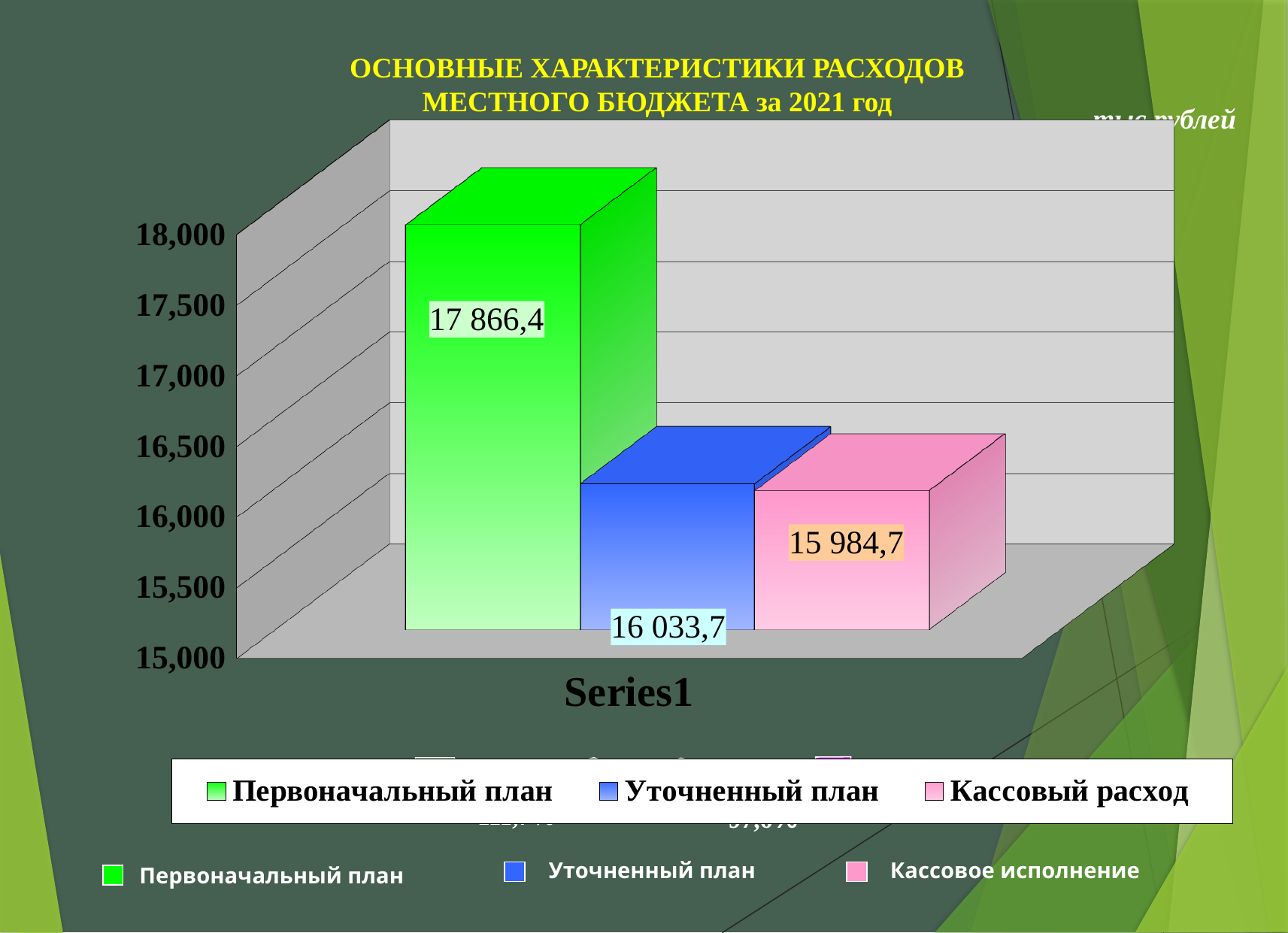
What is the difference between Первоначальный план and Уточненный план? 1 832,7 What is the value for Кассовый расход? 15 984,7 What is the value for Уточненный план? 16 033,7 What is the difference between Уточненный план and Кассовый расход? 49 How many series does the legend list? 3 What is the value for Первоначальный план? 17 866,4 What unit is indicated in the top right corner of the chart? тыс.рублей Which series has the highest value? Первоначальный план Is the value for Первоначальный план greater or less than 17,500? greater Which series has the lowest value? Кассовый расход Which is larger, Первоначальный план or Кассовый расход? Первоначальный план What kind of chart is shown on the slide? bar chart